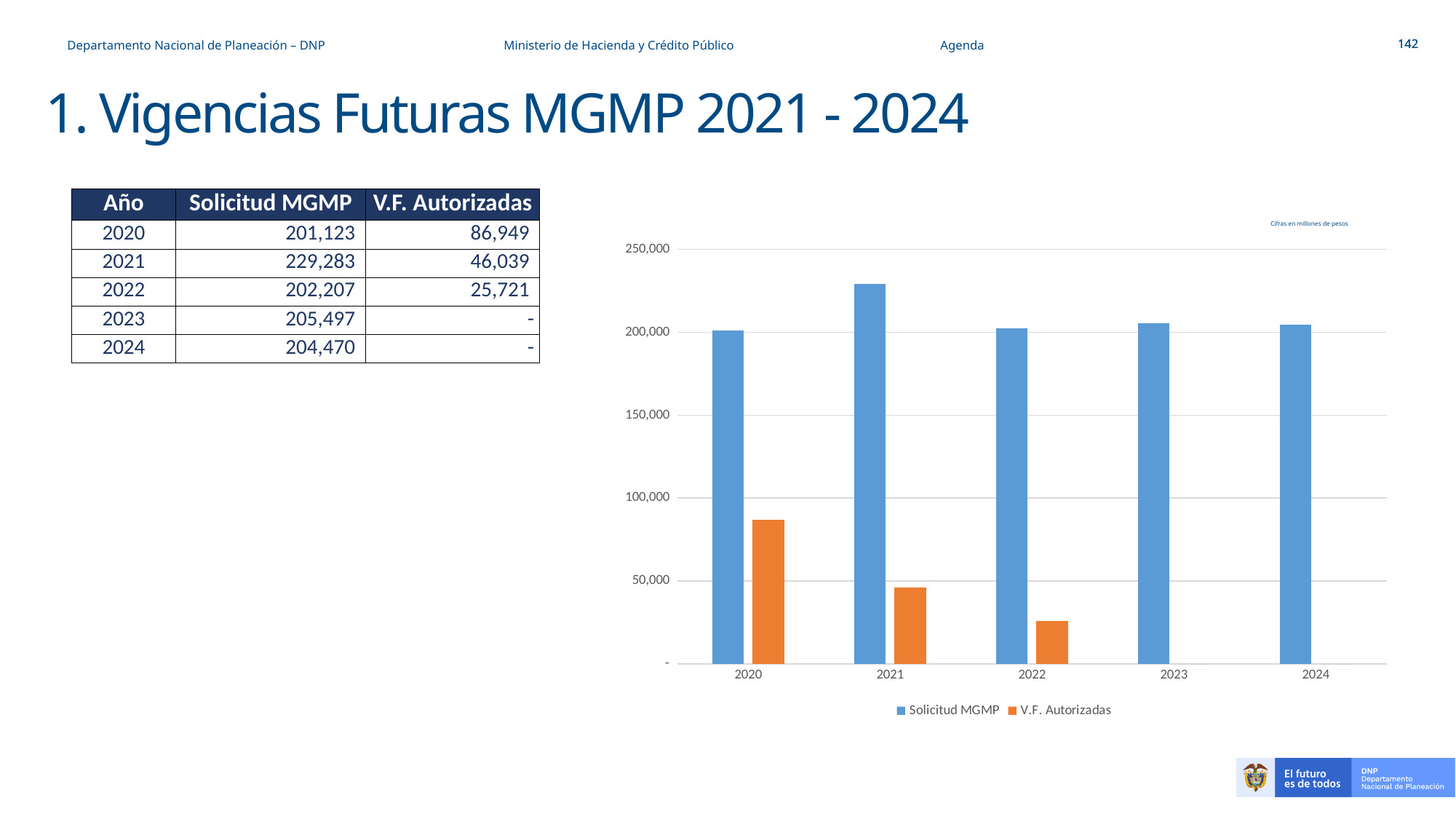
What colour represents V.F. Autorizadas in the chart? orange Which year has the highest Solicitud MGMP value in the chart? 2021 Among 2020, 2021 and 2022, which year has the lowest V.F. Autorizadas value? 2022 How many series does the chart legend list? 2 Is the Solicitud MGMP value for 2021 greater or less than 200,000? greater Is the V.F. Autorizadas value for 2020 greater or less than 100,000? less Do the V.F. Autorizadas values rise or fall from 2020 to 2022? fall In 2020, which is larger: Solicitud MGMP or V.F. Autorizadas? Solicitud MGMP How many years are shown on the x axis of the chart? 5 What kind of chart is shown on the slide? bar chart What is the Solicitud MGMP value for 2020? 201,123 What is the difference between Solicitud MGMP and V.F. Autorizadas in 2021? 183,244